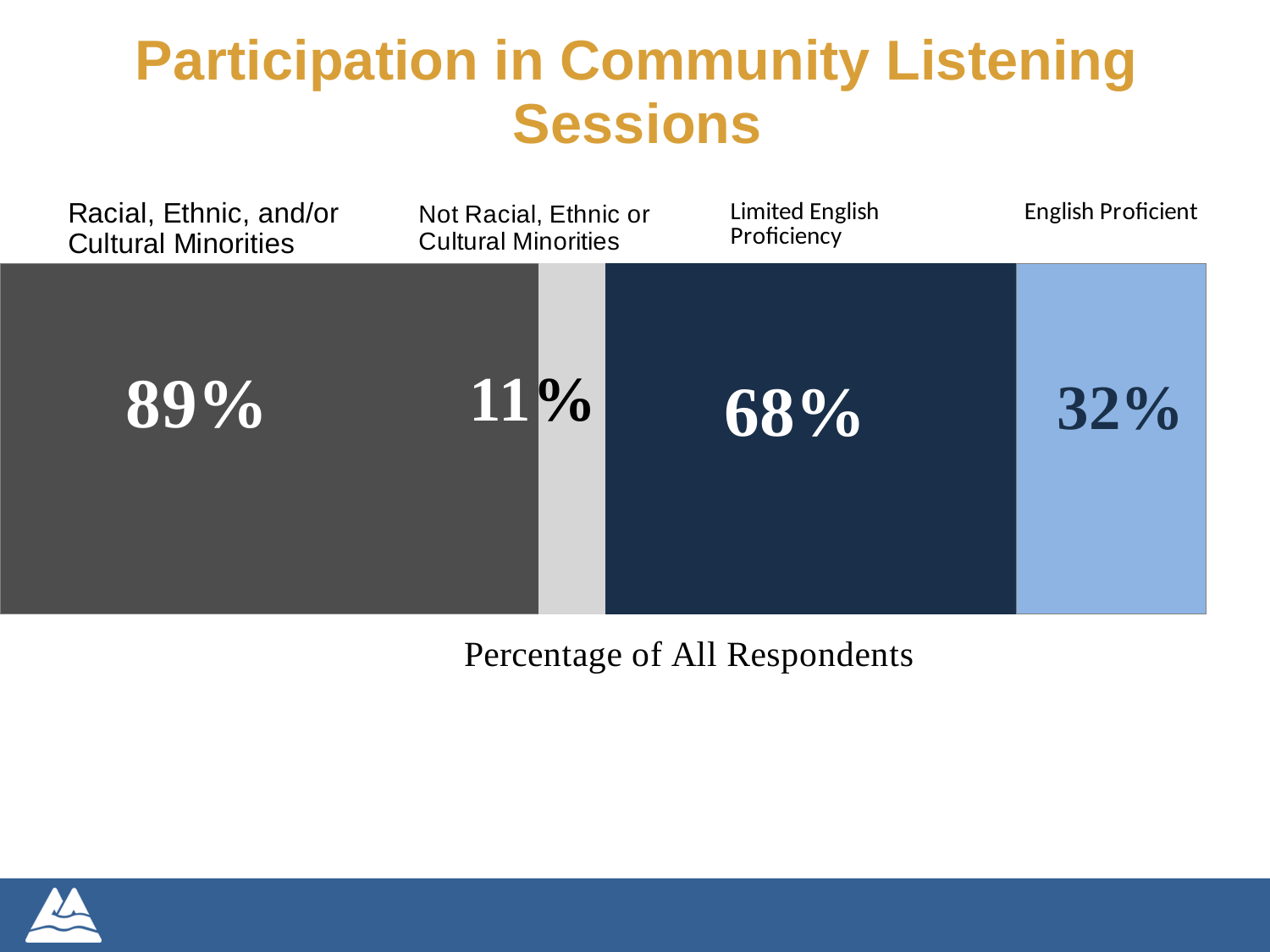
How many labelled categories are shown in the chart? 4 What is the label printed below the chart? Percentage of All Respondents What percentage of respondents were Not Racial, Ethnic or Cultural Minorities? 11% What is the difference between the Racial, Ethnic, and/or Cultural Minorities percentage and the Not Racial, Ethnic or Cultural Minorities percentage? 78% Which is larger: the percentage with Limited English Proficiency or the percentage who are English Proficient? Limited English Proficiency What percentage of respondents were Racial, Ethnic, and/or Cultural Minorities? 89% Which category has the highest percentage of all respondents? Racial, Ethnic, and/or Cultural Minorities Which category has the lowest percentage of all respondents? Not Racial, Ethnic or Cultural Minorities What kind of chart is shown on the slide? Stacked bar chart What percentage of respondents were English Proficient? 32% What percentage of respondents had Limited English Proficiency? 68% What is the difference between the Limited English Proficiency and English Proficient percentages? 36%